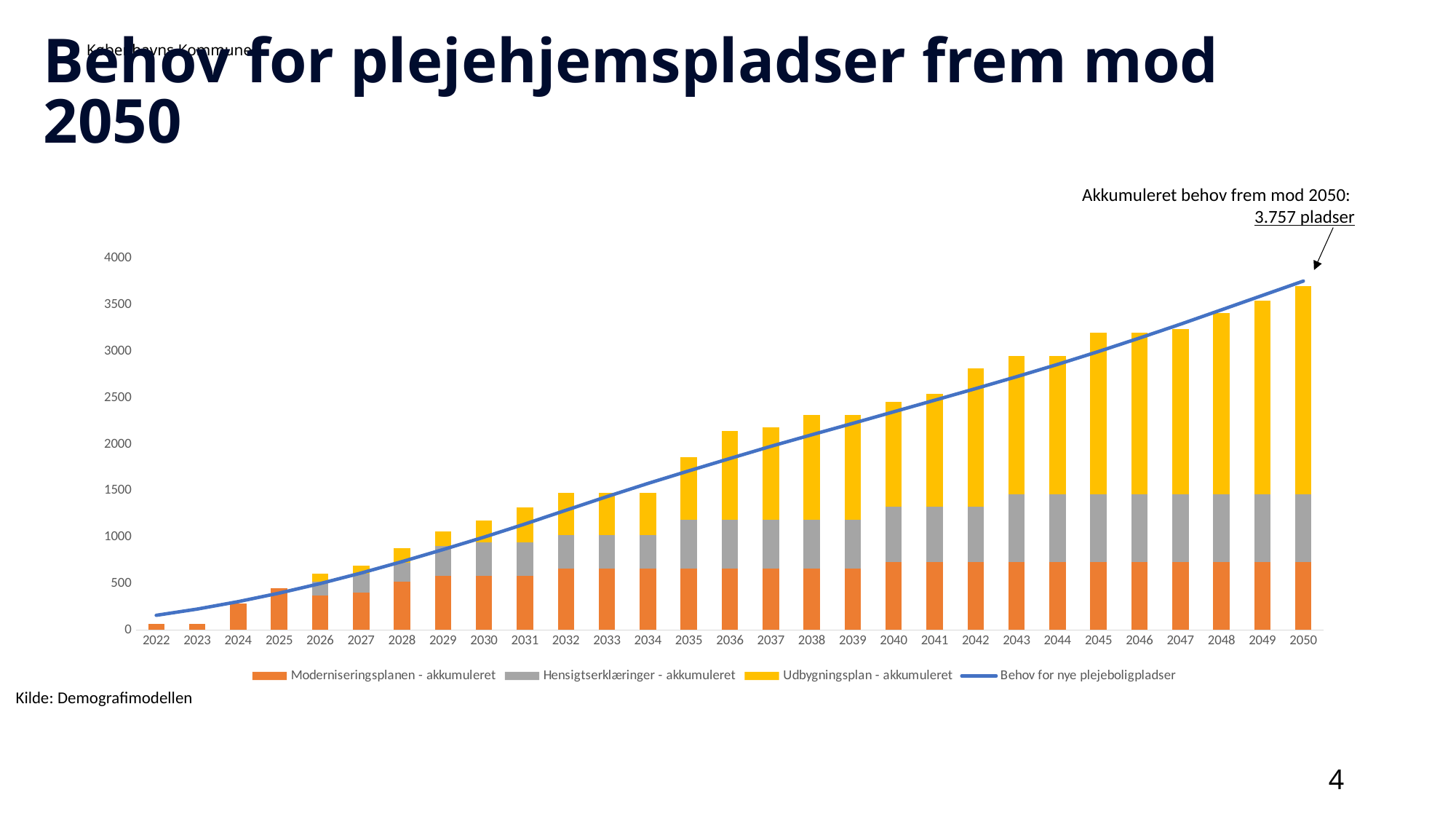
Is the total stacked bar value for 2022 greater or less than 500? less Which year has a taller stacked bar, 2030 or 2040? 2040 How many years are shown along the x axis? 29 Is the total stacked bar value for 2035 greater or less than 1500? greater How many series does the legend list? 4 Which series is shown as a line rather than bars? Behov for nye plejeboligpladser Is the total stacked bar value for 2030 greater or less than 1000? greater What type of chart is shown on the slide? Stacked bar chart with a line Which year has the tallest stacked bar? 2050 Do the stacked bar totals rise or fall from 2022 to 2050? rise What is the accumulated need for places by 2050 stated in the annotation? 3.757 pladser